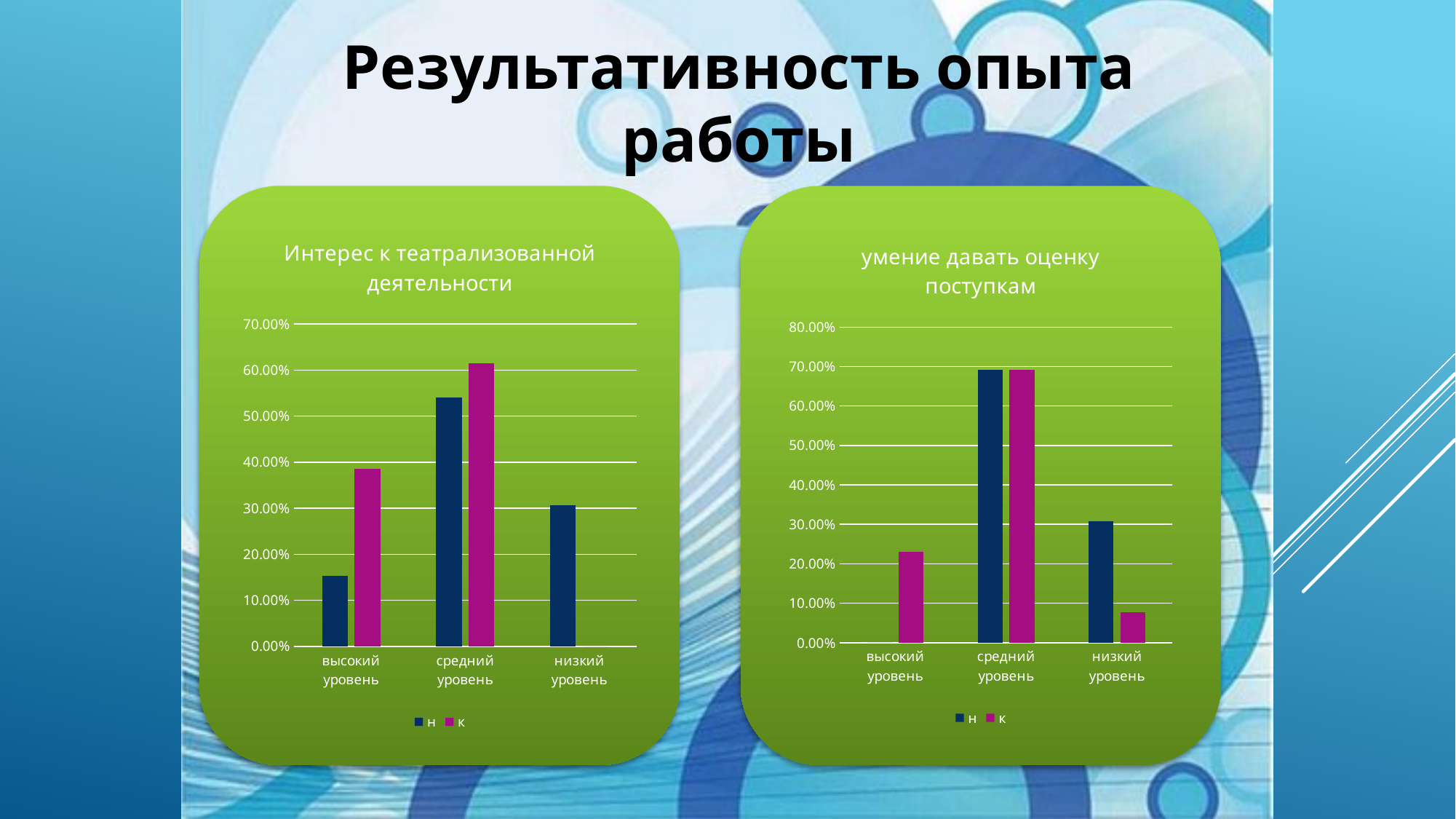
How many series does the legend of the left chart "Интерес к театрализованной деятельности" list? 2 In the left chart "Интерес к театрализованной деятельности", which is larger for "высокий уровень": series "н" or series "к"? к In the left chart "Интерес к театрализованной деятельности", is the value of series "к" for "средний уровень" greater or less than 60.00%? greater What type of chart is used in the left chart titled "Интерес к театрализованной деятельности"? bar chart In the right chart "умение давать оценку поступкам", which category has the lowest value for series "к"? низкий уровень In the right chart "умение давать оценку поступкам", is the value of series "н" for "средний уровень" greater or less than 60.00%? greater How many categories are shown on the x axis of the right chart "умение давать оценку поступкам"? 3 In the left chart "Интерес к театрализованной деятельности", which category has the highest value for series "н"? средний уровень In the right chart "умение давать оценку поступкам", which is larger for "низкий уровень": series "н" or series "к"? н What are the legend entries in the right chart "умение давать оценку поступкам"? н, к In the right chart "умение давать оценку поступкам", is the value of series "к" for "низкий уровень" greater or less than 10.00%? less